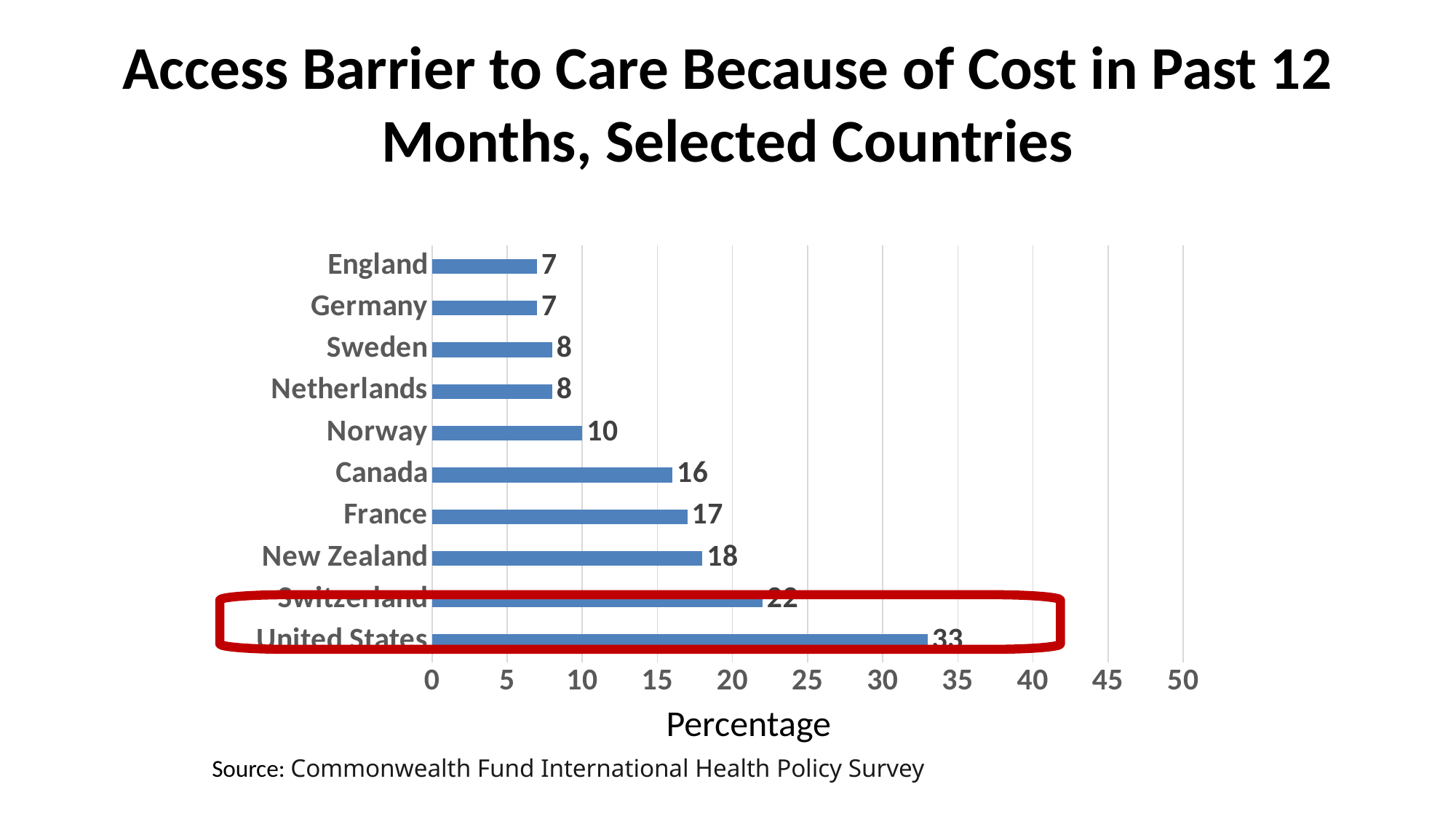
What is the difference between the values for the United States and Switzerland? 11 What is the value for Norway? 10 Which has a larger value, Sweden or Norway? Norway What is the value for Canada? 16 What is the difference between the values for New Zealand and Norway? 8 What is the value for Switzerland? 22 Is the value for the United States greater or less than 30? greater How many countries are shown in the chart? 10 Which has a larger value, France or Canada? France Which country has the highest value? United States What kind of chart is shown on the slide? Bar chart What is the label of the horizontal axis? Percentage